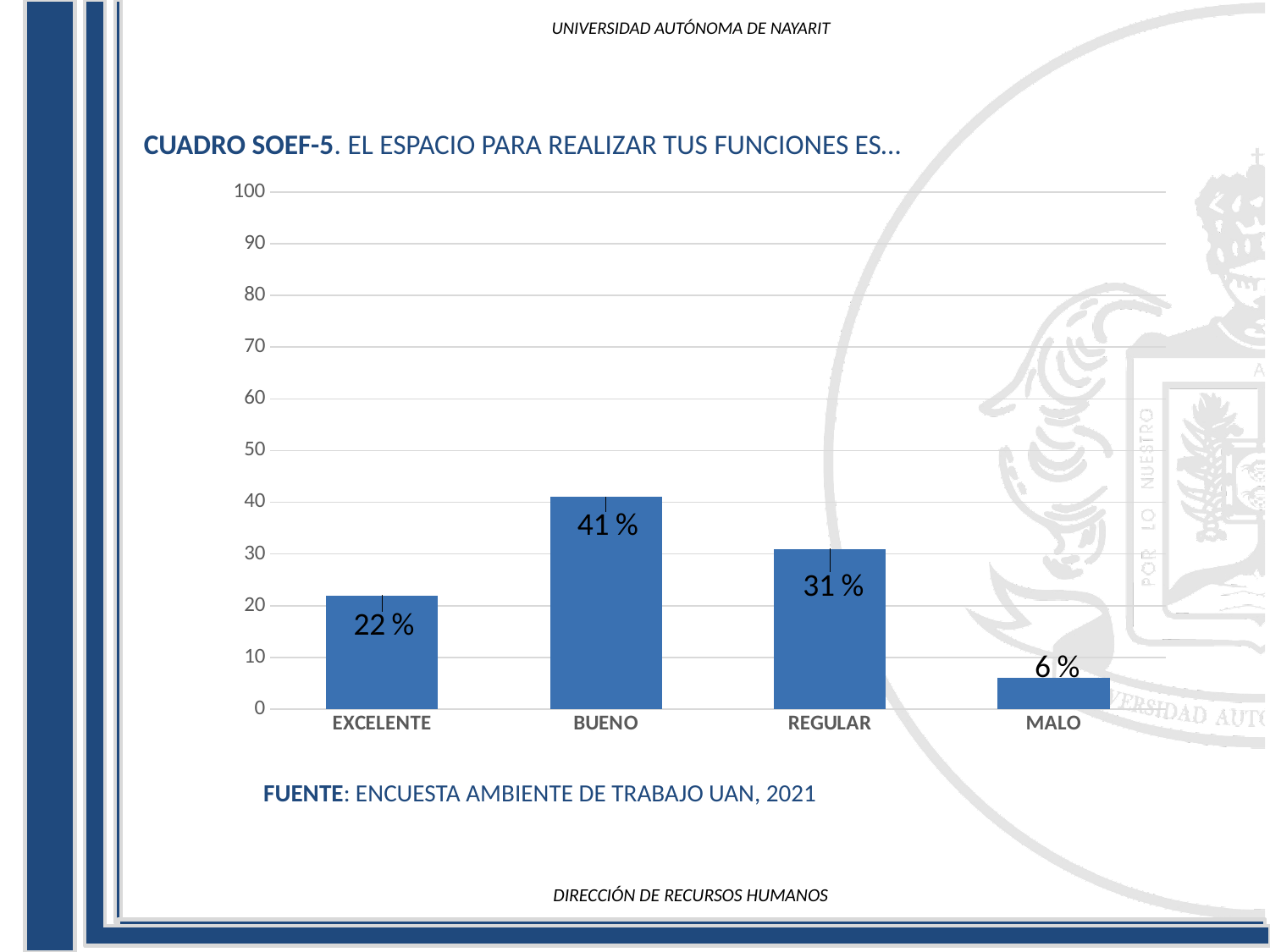
What is the value for EXCELENTE? 22 % What is the difference between the values for BUENO and REGULAR? 10 % What is the value for REGULAR? 31 % Which category has the highest value? BUENO What is the value for BUENO? 41 % Is the value for REGULAR greater or less than 40? less What is the source cited below the chart? ENCUESTA AMBIENTE DE TRABAJO UAN, 2021 Which category has the lowest value? MALO What is the value for MALO? 6 % How many categories are shown on the x axis? 4 What kind of chart is shown on the slide? bar chart Which is larger, the value for EXCELENTE or the value for REGULAR? REGULAR